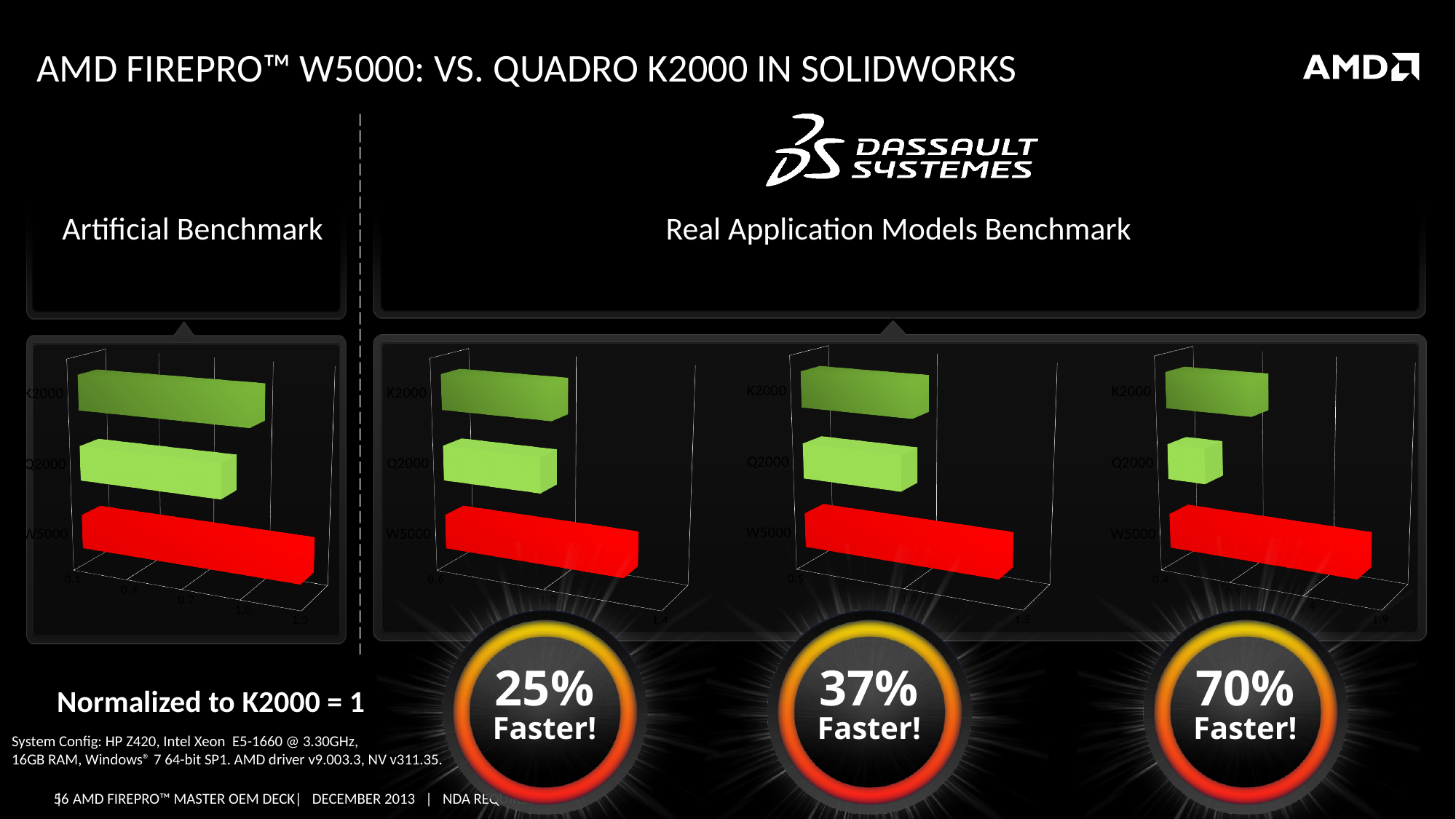
In the leftmost chart under Real Application Models Benchmark, which category has the longest bar? W5000 In the Artificial Benchmark chart, which is larger, the value for W5000 or the value for Q2000? W5000 What kind of chart is the Artificial Benchmark chart? bar chart In the rightmost chart under Real Application Models Benchmark, which category has the shortest bar? Q2000 In the Artificial Benchmark chart, which category has the longest bar? W5000 In the Artificial Benchmark chart, what colour is the W5000 bar? red How many categories does the Artificial Benchmark chart show? 3 In the middle chart under Real Application Models Benchmark, which is larger, the value for K2000 or the value for Q2000? K2000 In the rightmost chart under Real Application Models Benchmark, which category has the longest bar? W5000 How many bar charts are shown on the slide in total? 4 In the Artificial Benchmark chart, which category has the shortest bar? Q2000 What are the three category labels shown on each chart? K2000, Q2000, W5000